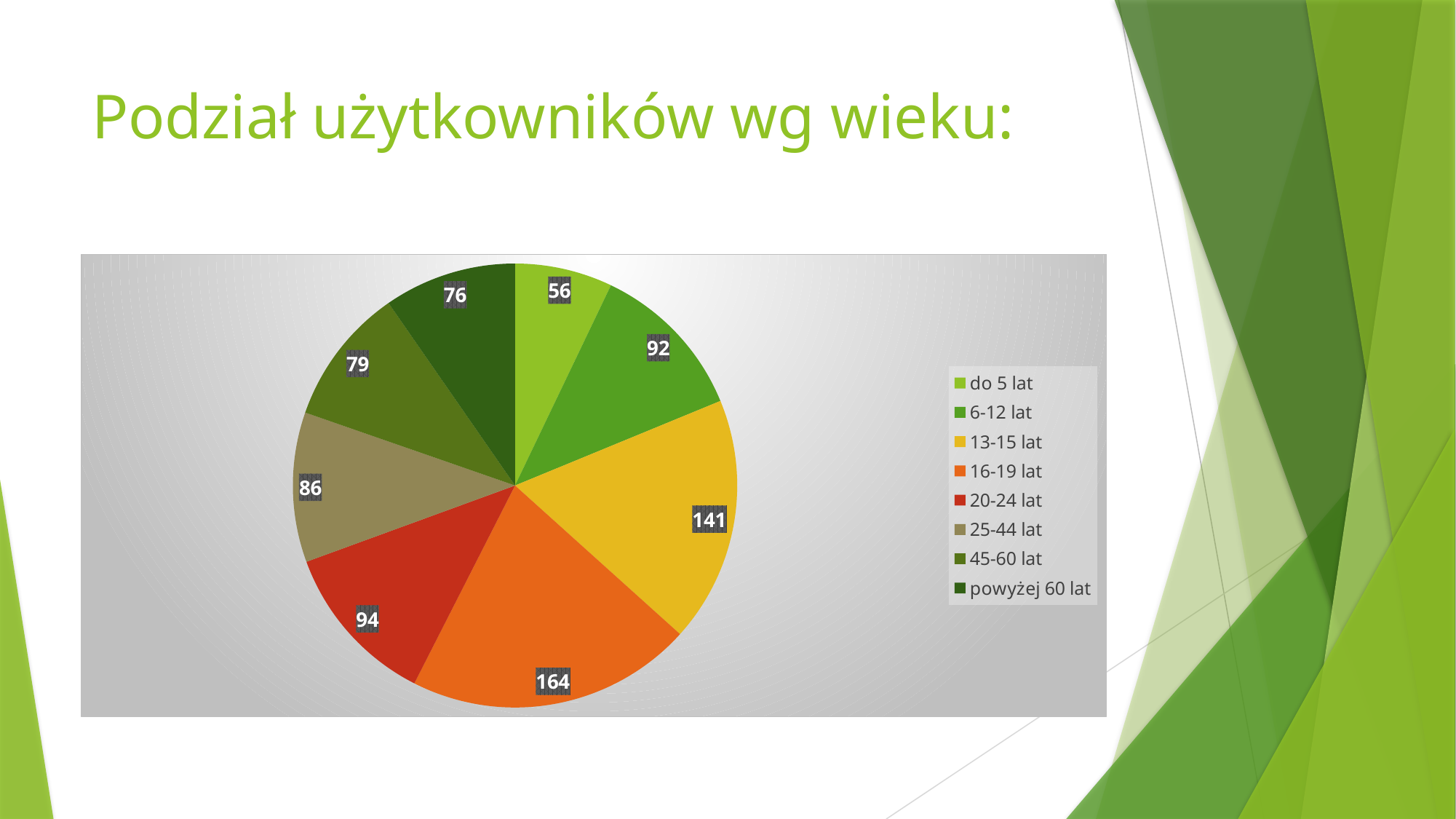
What is the value for the 16-19 lat slice? 164 Which is larger, the value for 45-60 lat or the value for 20-24 lat? 20-24 lat What is the value for the do 5 lat slice? 56 What type of chart is shown on the slide? pie chart What is the title of the slide containing the chart? Podział użytkowników wg wieku: How many slices does the pie chart have? 8 What is the value for the 25-44 lat slice? 86 Which age group has the largest slice? 16-19 lat What is the difference between the 6-12 lat and do 5 lat values? 36 Which age group has the smallest slice? do 5 lat Which legend entry is shown last in the legend? powyżej 60 lat What is the difference between the 16-19 lat and 13-15 lat values? 23